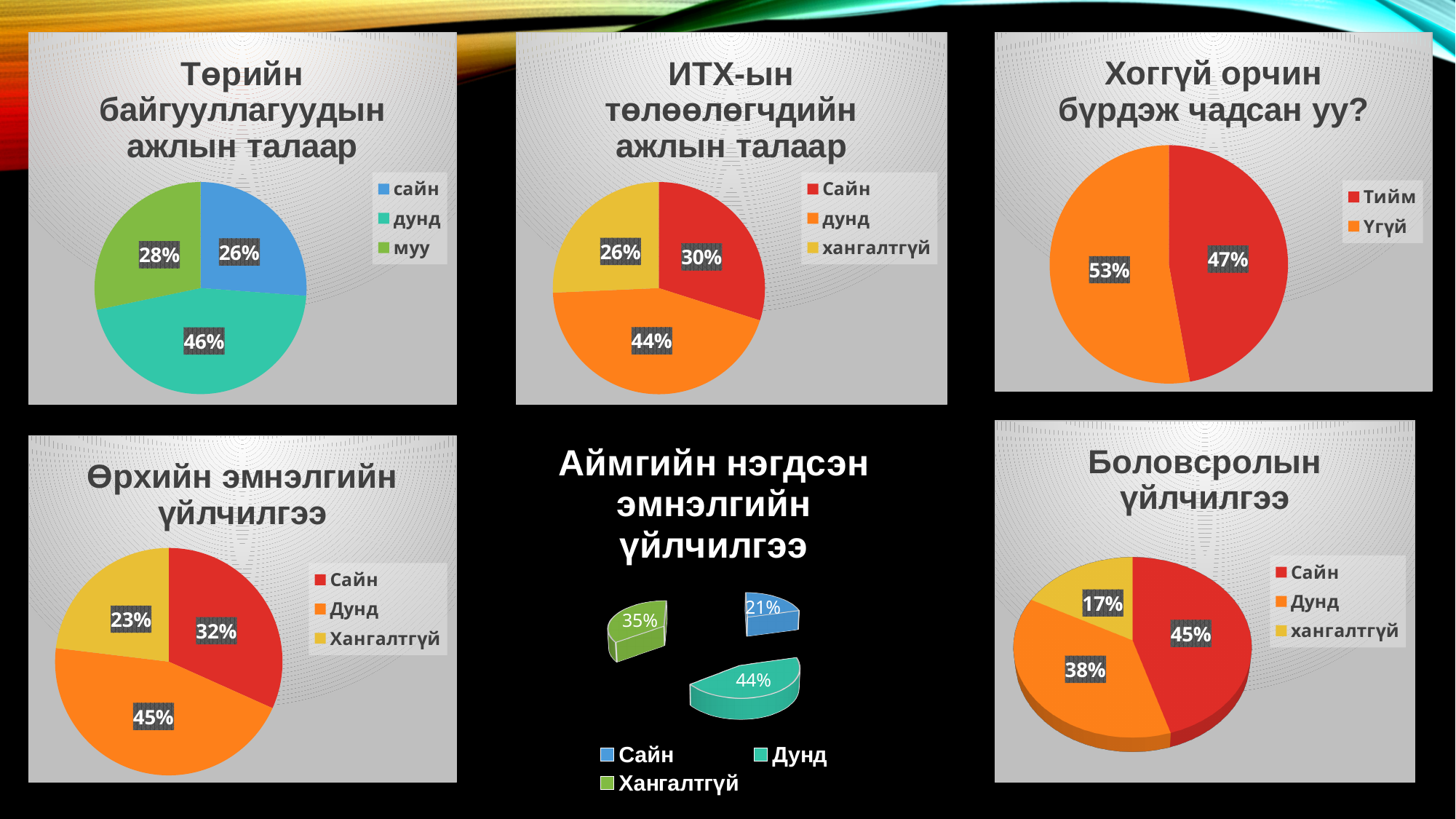
In the chart titled "Аймгийн нэгдсэн эмнэлгийн үйлчилгээ", what share is labelled "Сайн"? 21% In the chart titled "Хоггүй орчин бүрдэж чадсан уу?", what share is labelled "Үгүй"? 53% In the chart titled "Төрийн байгууллагуудын ажлын талаар", what share is labelled "дунд"? 46% In the chart titled "Өрхийн эмнэлгийн үйлчилгээ", what share is labelled "Хангалтгүй"? 23% In the chart titled "Төрийн байгууллагуудын ажлын талаар", which category has the smallest slice? сайн In the chart titled "ИТХ-ын төлөөлөгчдийн ажлын талаар", what share is labelled "Сайн"? 30% In the chart titled "Боловсролын үйлчилгээ", which category has the largest slice? Сайн In the chart titled "Өрхийн эмнэлгийн үйлчилгээ", which is larger, "Сайн" or "Дунд"? Дунд In the chart titled "ИТХ-ын төлөөлөгчдийн ажлын талаар", which category has the largest slice? дунд How many categories does the legend list in the chart titled "Хоггүй орчин бүрдэж чадсан уу?"? 2 In the chart titled "Хоггүй орчин бүрдэж чадсан уу?", what is the difference between the "Үгүй" and "Тийм" shares? 6% In the chart titled "Боловсролын үйлчилгээ", what share is labelled "Дунд"? 38%